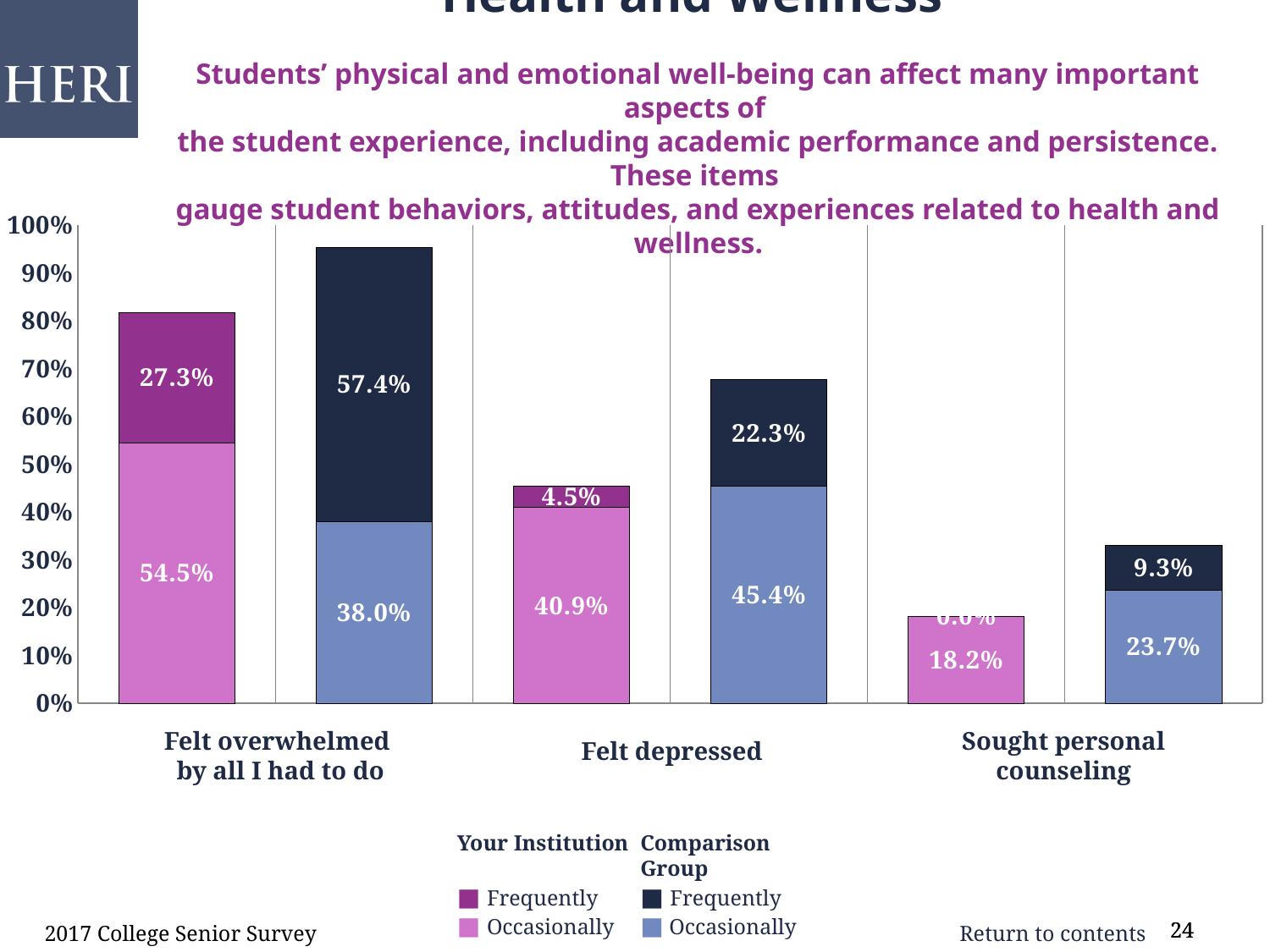
How many series does the legend list? 4 What kind of chart is shown on the slide? Stacked bar chart What percentage of the Comparison Group frequently felt overwhelmed by all they had to do? 57.4% Which is larger for 'Felt overwhelmed by all I had to do': the Your Institution 'Occasionally' value or the Comparison Group 'Occasionally' value? Your Institution (54.5%) What percentage of students at Your Institution frequently felt depressed? 4.5% How many categories are shown on the x axis of the chart? 3 What is the difference between the Comparison Group's and Your Institution's 'Frequently' values for 'Felt depressed'? 17.8% What percentage of the Comparison Group occasionally sought personal counseling? 23.7% What is the total stacked bar value for the Comparison Group for 'Felt overwhelmed by all I had to do'? 95.4% What percentage of students at Your Institution occasionally felt overwhelmed by all they had to do? 54.5% What is the total stacked bar value for Your Institution for 'Felt depressed'? 45.4% Which category has the lowest total stacked bar for the Comparison Group? Sought personal counseling